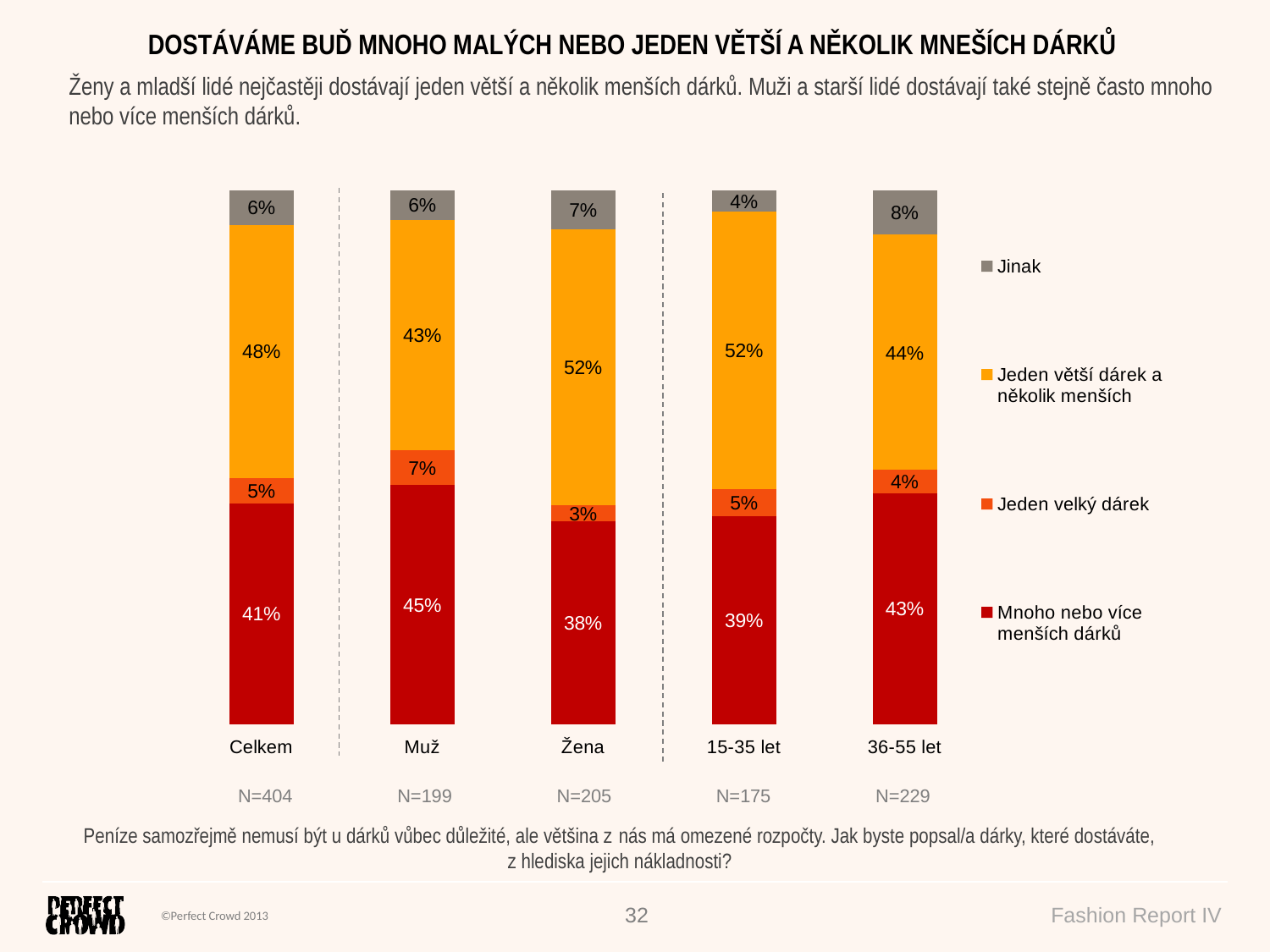
What is the sample size (N) shown for the Žena category? N=205 Which category has the lowest value for "Jeden velký dárek"? Žena Which category has the highest value for "Mnoho nebo více menších dárků"? Muž How many categories are shown on the x axis? 5 How many series does the legend list? 4 What is the difference between the "Jeden větší dárek a několik menších" values for Žena and Muž? 9% What is the value for "Jeden velký dárek" in the Muž bar? 7% What is the value for "Mnoho nebo více menších dárků" in the Celkem bar? 41% Which is larger: the "Mnoho nebo více menších dárků" value for 15-35 let or for 36-55 let? 36-55 let What kind of chart is shown on the slide? Stacked bar chart What is the value for "Jinak" in the 36-55 let bar? 8% What is the value for "Jeden větší dárek a několik menších" in the Žena bar? 52%